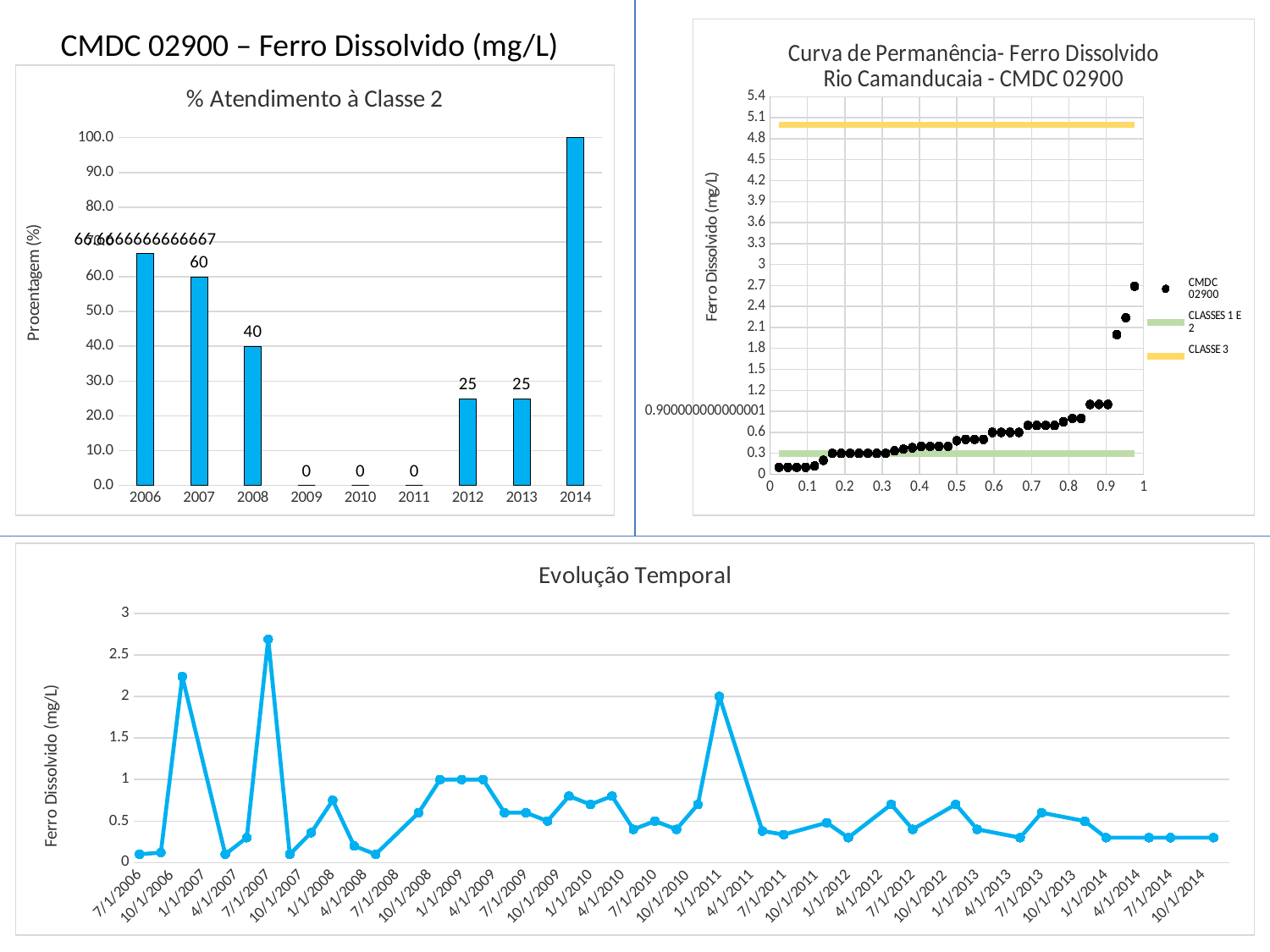
In the '% Atendimento à Classe 2' bar chart, what is the difference between the values for 2007 and 2008? 20 In the 'Curva de Permanência' chart on the top right, how many series does the legend list? 3 In the '% Atendimento à Classe 2' bar chart, how many years have a value of 0? 3 In the '% Atendimento à Classe 2' bar chart, which is larger, the value for 2007 or the value for 2012? 2007 In the '% Atendimento à Classe 2' bar chart, what is the value for 2012? 25 In the '% Atendimento à Classe 2' bar chart, what is the value for 2007? 60 What kind of chart is '% Atendimento à Classe 2'? bar chart In the '% Atendimento à Classe 2' bar chart, how many years are shown on the x axis? 9 What kind of chart is 'Evolução Temporal' at the bottom of the slide? line chart In the '% Atendimento à Classe 2' bar chart, which year has the highest value? 2014 In the 'Evolução Temporal' chart, is the value for 7/1/2007 greater or less than 2.5? greater In the '% Atendimento à Classe 2' bar chart, what is the value for 2008? 40